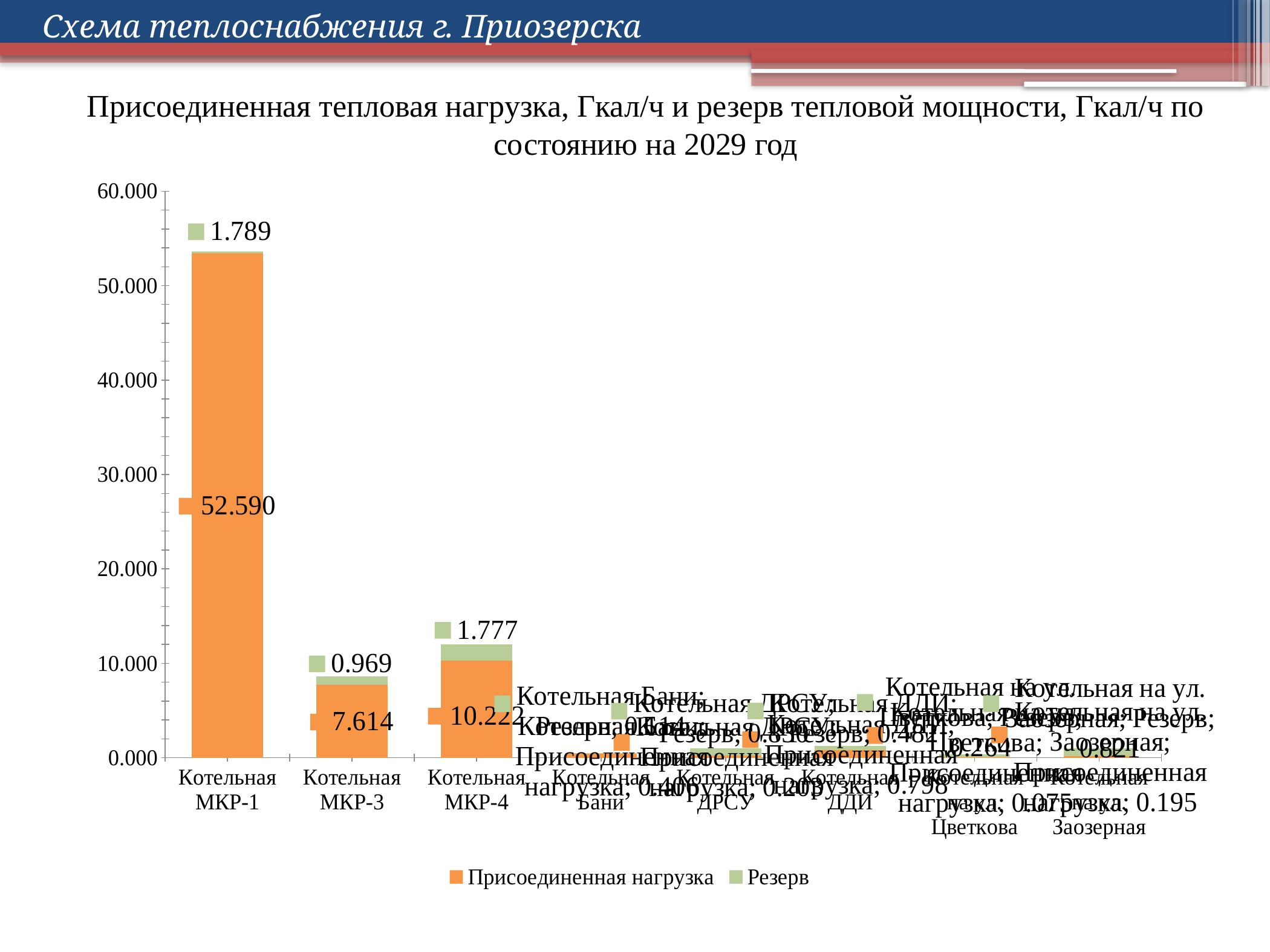
How many series does the legend list? 2 Is the Присоединенная нагрузка for Котельная МКР-1 greater or less than 50.000? greater What is the value of Резерв for Котельная МКР-1? 1.789 What is the total of the stacked bar for Котельная МКР-1 (Присоединенная нагрузка plus Резерв)? 54.379 Which has a larger Присоединенная нагрузка, Котельная МКР-3 or Котельная МКР-4? Котельная МКР-4 What kind of chart is shown on the slide? Stacked bar chart What is the value of Присоединенная нагрузка for Котельная МКР-3? 7.614 What is the value of Резерв for Котельная МКР-4? 1.777 What is the difference in Присоединенная нагрузка between Котельная МКР-4 and Котельная МКР-3? 2.608 How many categories are shown on the x axis? 8 Which category has the highest Присоединенная нагрузка? Котельная МКР-1 What is the value of Присоединенная нагрузка for Котельная МКР-1? 52.590